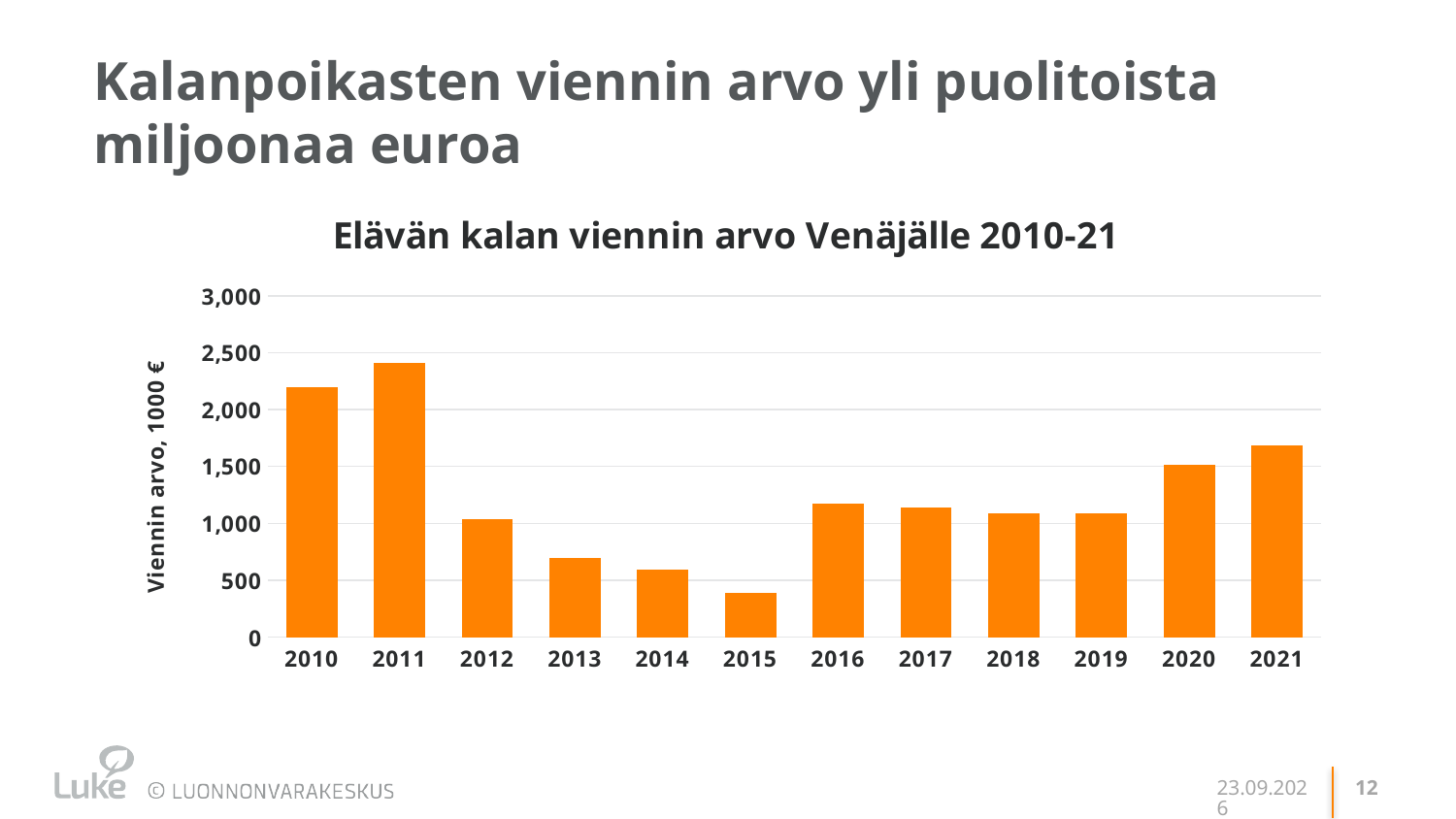
Which year has the lowest export value in the chart? 2015 Do the values rise or fall from 2010 to 2015? fall Which year has the larger value, 2010 or 2021? 2010 What is the title of the chart? Elävän kalan viennin arvo Venäjälle 2010-21 What is the label of the vertical axis of the chart? Viennin arvo, 1000 € Is the value for 2021 greater or less than 1,500? greater Which year has the highest export value in the chart? 2011 How many years are shown on the x axis of the chart? 12 Is the value for 2013 greater or less than 1,000? less Is the value for 2015 greater or less than 500? less What type of chart is shown on the slide? bar chart